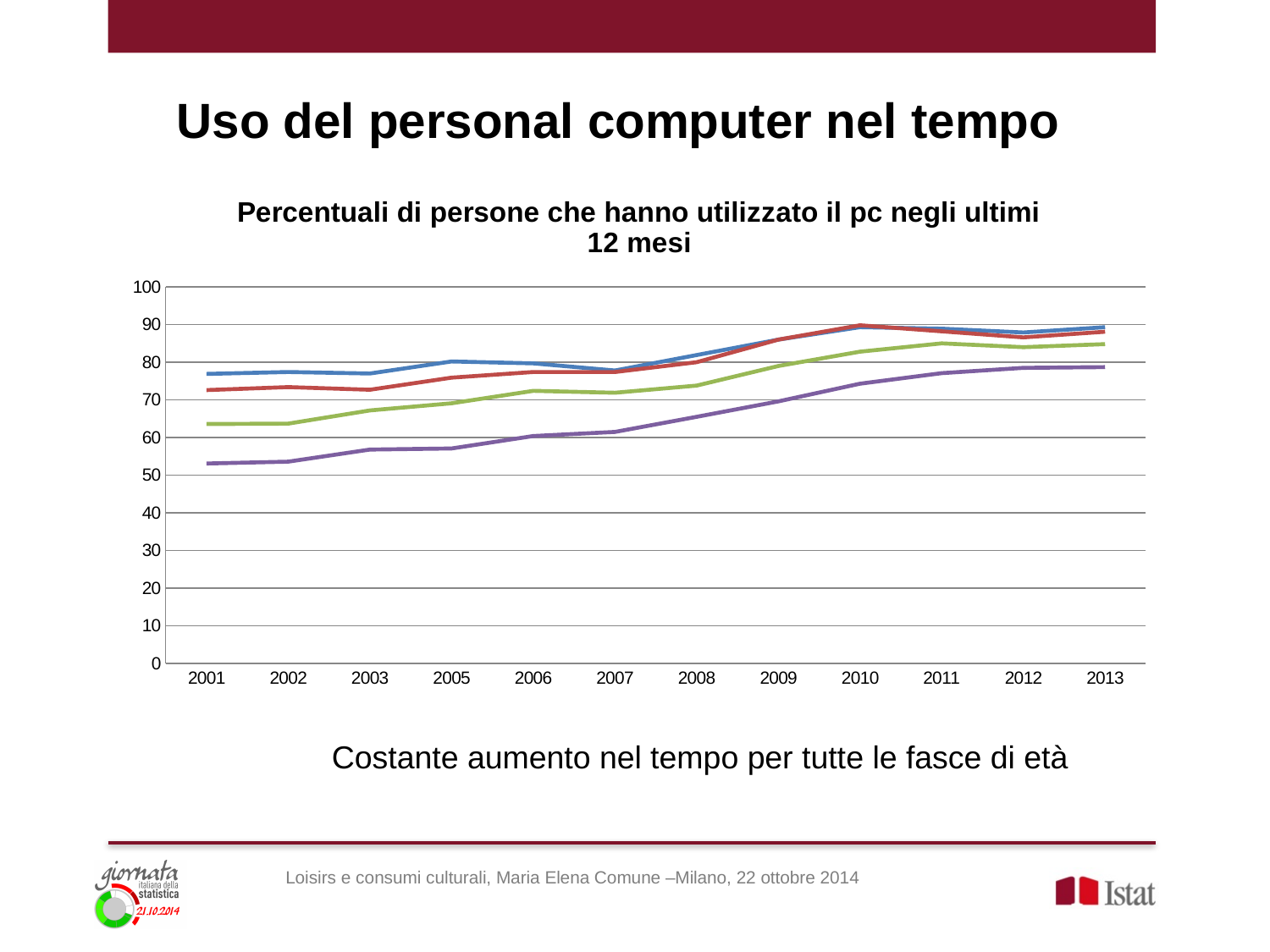
Is the value of the green line in 2013 greater or less than 80? greater What is the title of the chart? Percentuali di persone che hanno utilizzato il pc negli ultimi 12 mesi What kind of chart is shown on the slide? line chart Is the value of the purple line in 2001 greater or less than 60? less Do the values in the chart generally rise or fall from 2001 to 2013? rise What is the first year shown on the x axis? 2001 What is the last year shown on the x axis? 2013 Which coloured line has the lowest values across all years? purple How many years are shown on the x axis of the chart? 12 How many lines are plotted in the chart? 4 What is the maximum value shown on the y axis? 100 Is the value of the red line in 2001 greater or less than 70? greater